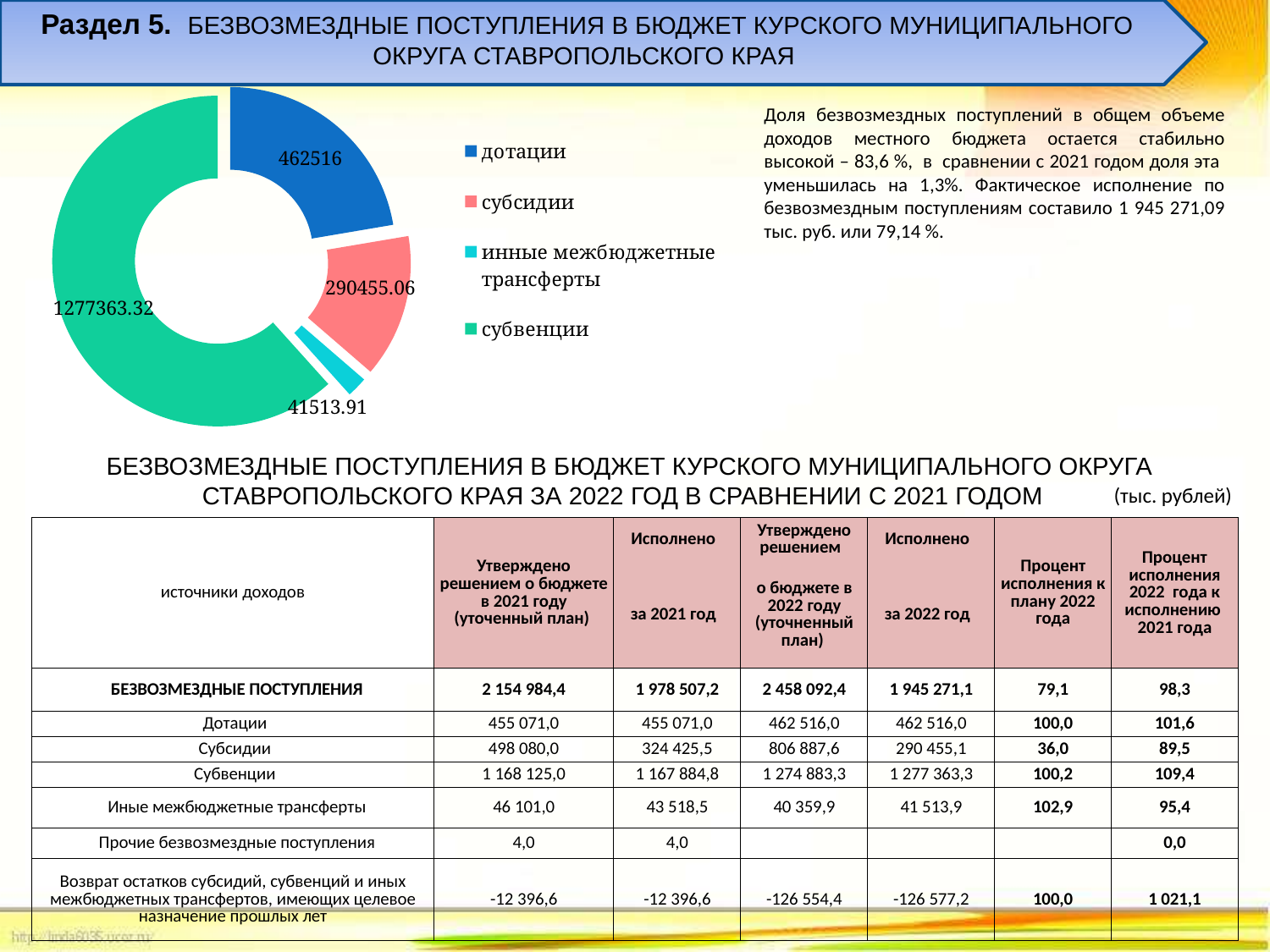
What value is shown for субсидии in the doughnut chart? 290455.06 What value is shown for субвенции in the doughnut chart? 1277363.32 What is the difference between the values for дотации and субсидии in the doughnut chart? 172060.94 What value is shown for иные межбюджетные трансферты in the doughnut chart? 41513.91 Which category has the largest value in the doughnut chart? субвенции What colour is the субвенции slice in the doughnut chart? green What value is shown for дотации in the doughnut chart? 462516 How many categories does the doughnut chart show? 4 What type of chart is shown on the slide? doughnut (pie) chart In the doughnut chart, which is larger: дотации or субсидии? дотации Which category has the smallest value in the doughnut chart? иные межбюджетные трансферты What is the difference between the values for субвенции and дотации in the doughnut chart? 814847.32